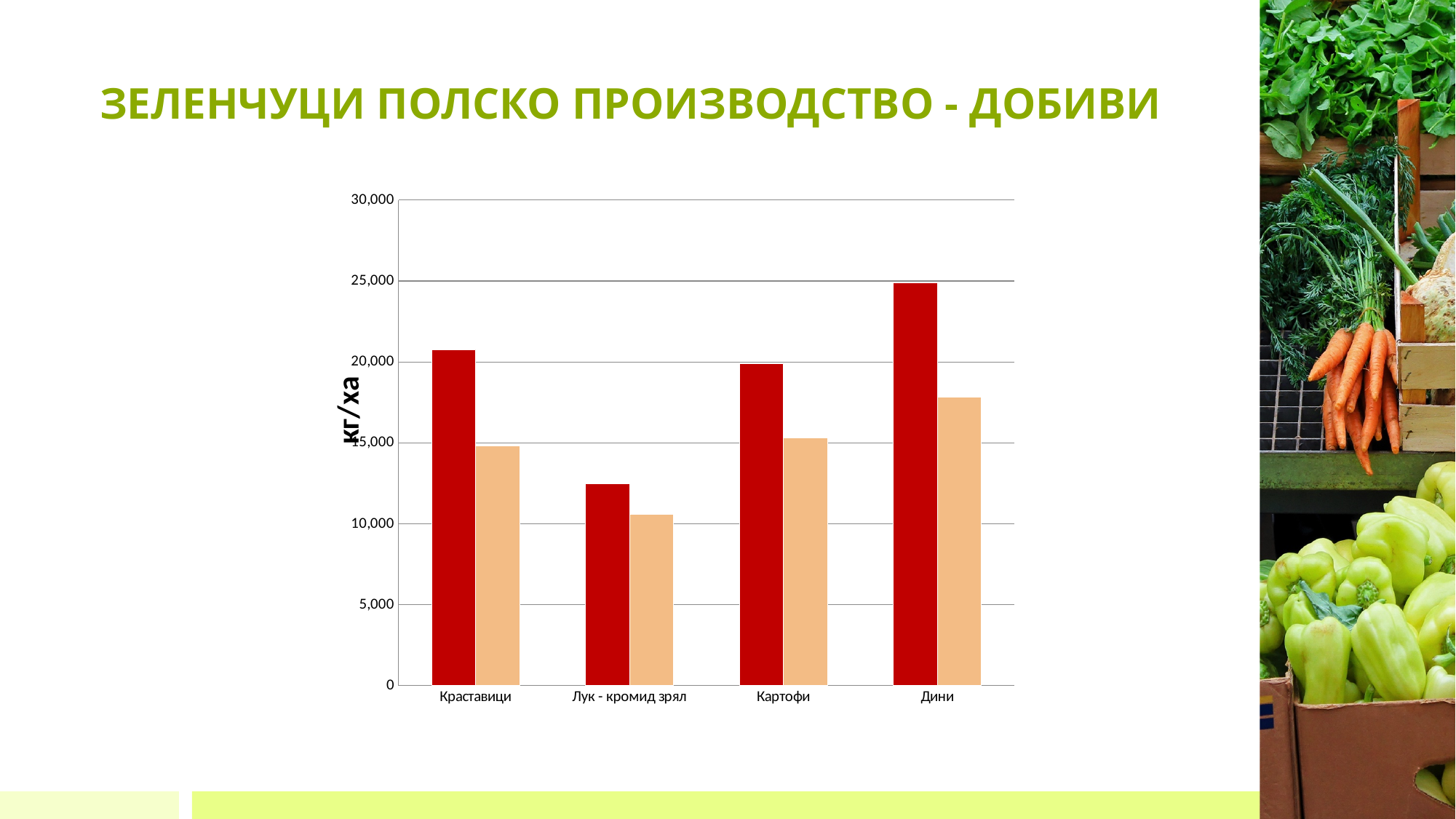
For Картофи, which bar is taller, the red one or the tan one? the red one Which category has the shortest red bar? Лук - кромид зрял Which category has the tallest tan bar? Дини What is the title of the slide containing the chart? ЗЕЛЕНЧУЦИ ПОЛСКО ПРОИЗВОДСТВО - ДОБИВИ Which category has the tallest red bar? Дини How many categories are shown on the x axis of the chart? 4 What is the label of the vertical axis of the chart? кг/ха Is the red bar for Лук - кромид зрял greater or less than 15,000? less Is the red bar for Дини greater or less than 20,000? greater How many bars are plotted for each category in the chart? 2 Which category has the shortest tan bar? Лук - кромид зрял What kind of chart is shown on the slide? bar chart